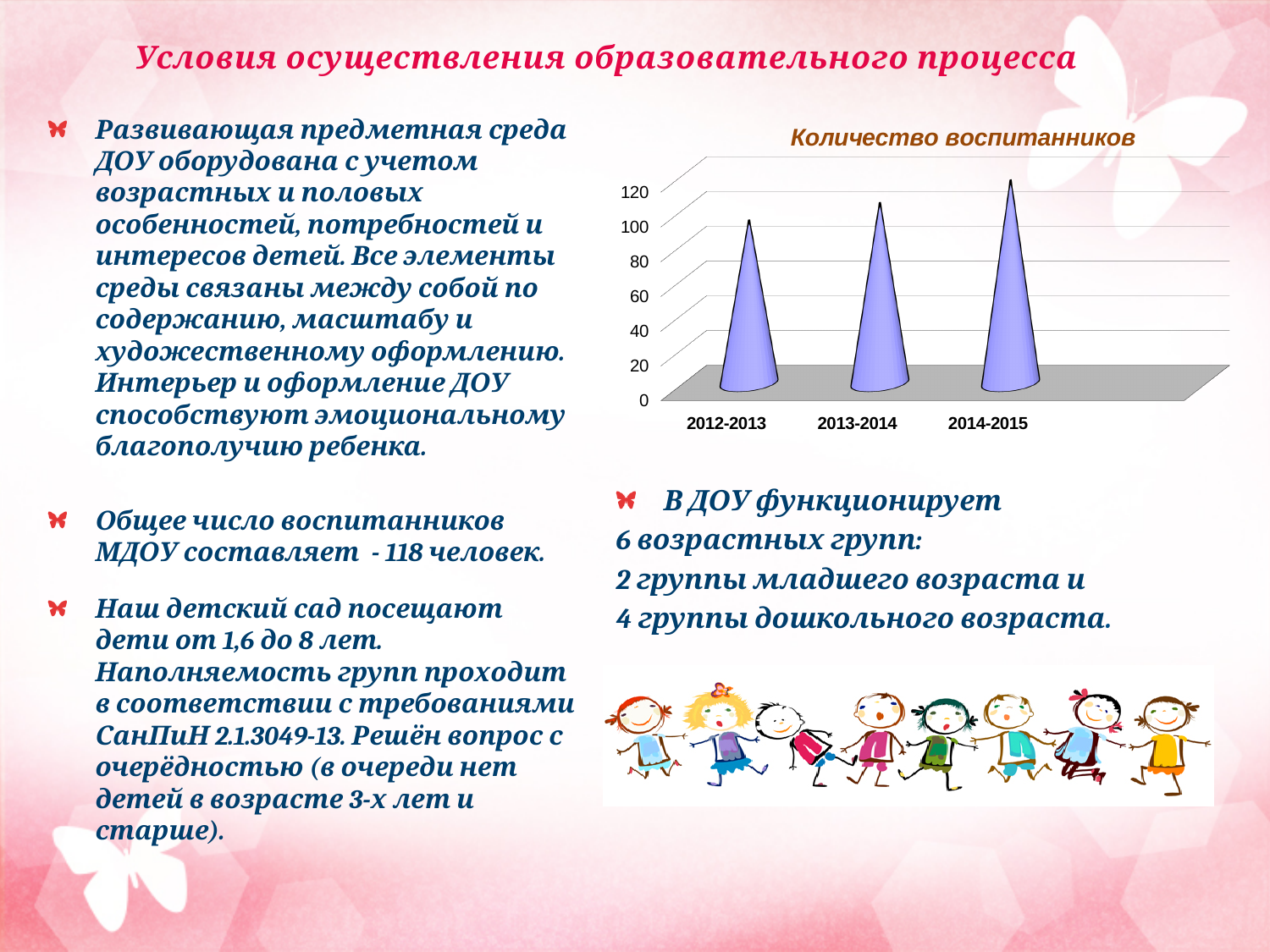
Is the value for 2012-2013 greater or less than 80? greater Do the values in the chart rise or fall from 2012-2013 to 2014-2015? rise Which is larger in the chart, the value for 2013-2014 or the value for 2012-2013? 2013-2014 Which category has the highest value in the chart? 2014-2015 Which is larger in the chart, the value for 2012-2013 or the value for 2014-2015? 2014-2015 What is the highest tick value shown on the vertical axis of the chart? 120 How many categories are shown on the x axis of the chart? 3 What is the title of the chart on the slide? Количество воспитанников Is the value for 2013-2014 greater or less than 60? greater Which category has the lowest value in the chart? 2012-2013 Is the value for 2014-2015 greater or less than 100? greater What kind of chart is shown on the slide? bar chart